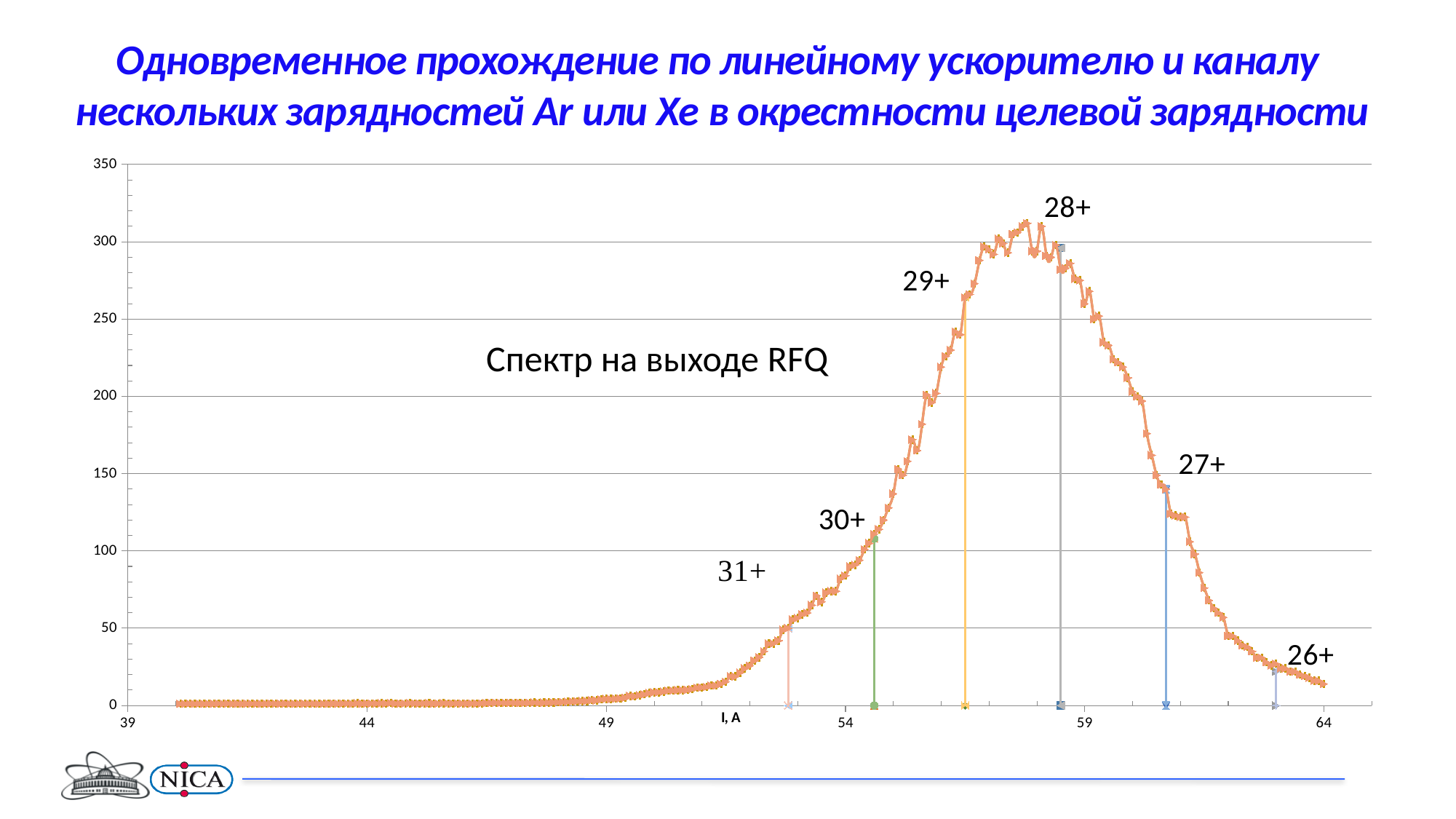
What kind of chart is shown on the slide? line chart Which charge-state label is placed at the peak of the spectrum? 28+ What is the label of the x axis? I, A Is the value at the 27+ marker greater or less than 100? greater Which marker has the larger value, 29+ or 27+? 29+ Does the curve rise or fall as the x axis goes from 59 to 64? fall What text annotation is written inside the plot area? Спектр на выходе RFQ Is the value at the 29+ marker greater or less than 250? greater How many charge-state labels (such as 28+) are marked on the chart? 6 Is the peak value of the spectrum greater or less than 300? greater